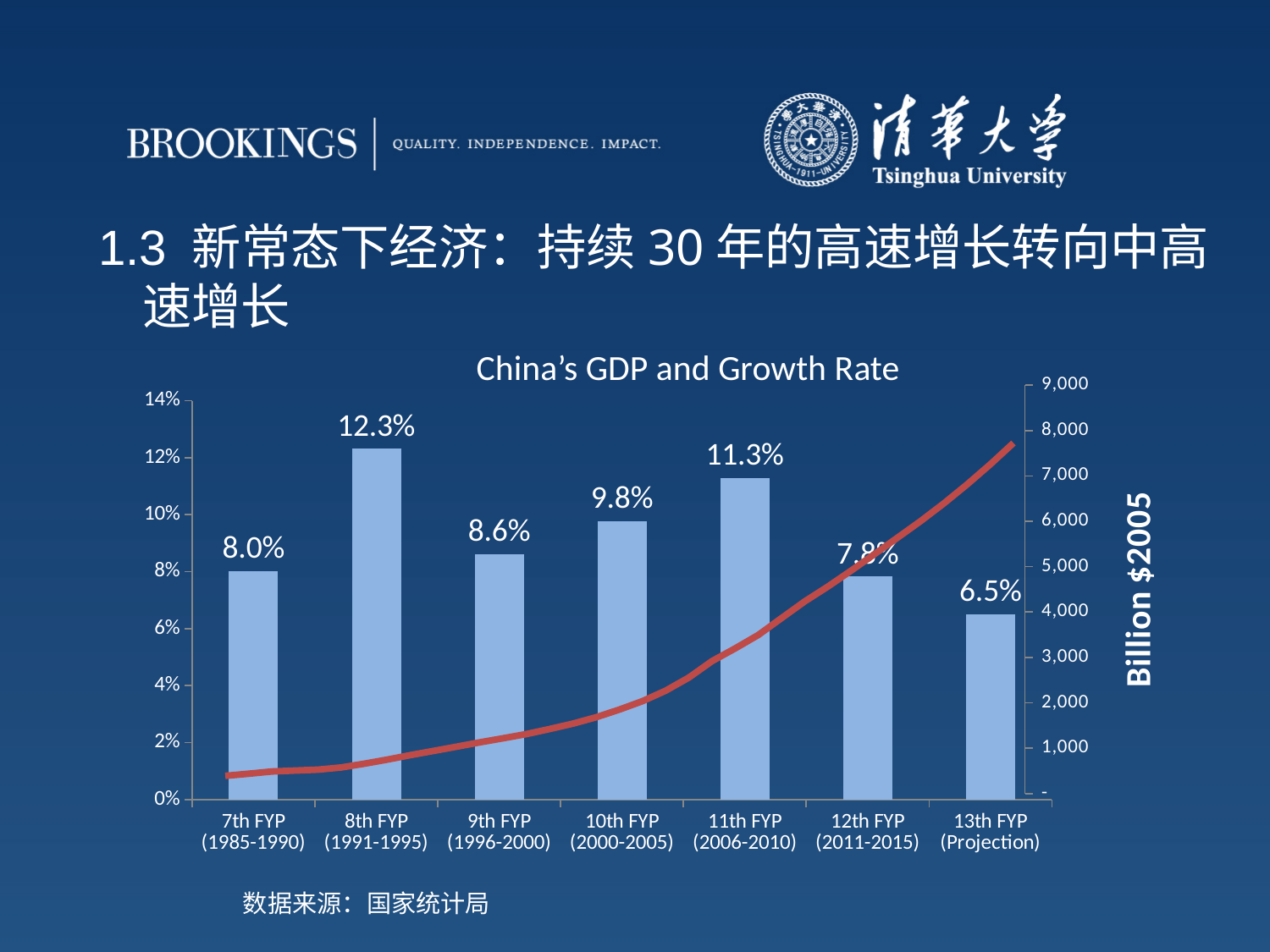
Which has a higher growth rate, the 9th FYP (1996-2000) or the 10th FYP (2000-2005)? 10th FYP (2000-2005) What is the growth rate shown for the 13th FYP (Projection)? 6.5% Which five-year plan period has the highest growth rate bar? 8th FYP (1991-1995) What is the growth rate shown for the 11th FYP (2006-2010)? 11.3% Does the red GDP line rise or fall from the 7th FYP to the 13th FYP? rise What is the title of the chart? China's GDP and Growth Rate Is the GDP line value for the 9th FYP (1996-2000) greater or less than 2,000 on the right axis? less Which five-year plan period has the lowest growth rate bar? 13th FYP (Projection) Is the GDP line value for the 13th FYP (Projection) greater or less than 7,000 on the right axis? greater What is the growth rate shown for the 8th FYP (1991-1995)? 12.3% What is the difference between the growth rates of the 8th FYP and the 13th FYP? 5.8% How many five-year plan periods are shown on the x axis? 7